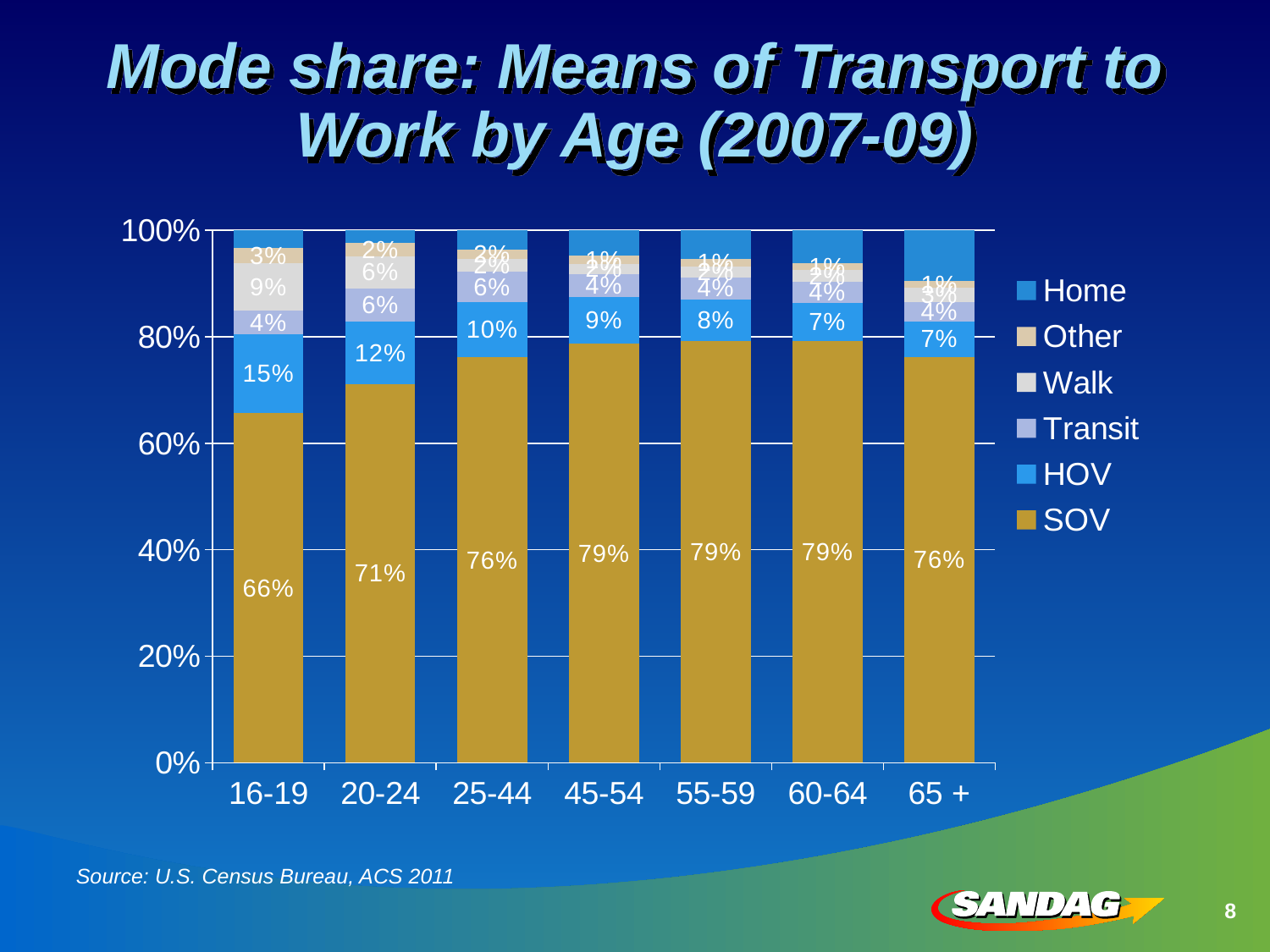
How many series does the legend list? 6 How many percentage points higher is the SOV share for 20-24 than for 16-19? 5 percentage points What is the SOV share for the 65 + age group? 76% What is the SOV share for the 16-19 age group? 66% Does the SOV share rise or fall from the 16-19 group to the 45-54 group? Rise How many age groups are shown on the x axis? 7 What kind of chart is shown on the slide? Stacked bar chart What is the HOV share for the 20-24 age group? 12% Which age group has the highest HOV share? 16-19 Which age group has the lowest SOV share? 16-19 What is the Walk share for the 16-19 age group? 9% Which is larger, the HOV share for 16-19 or for 25-44? 16-19